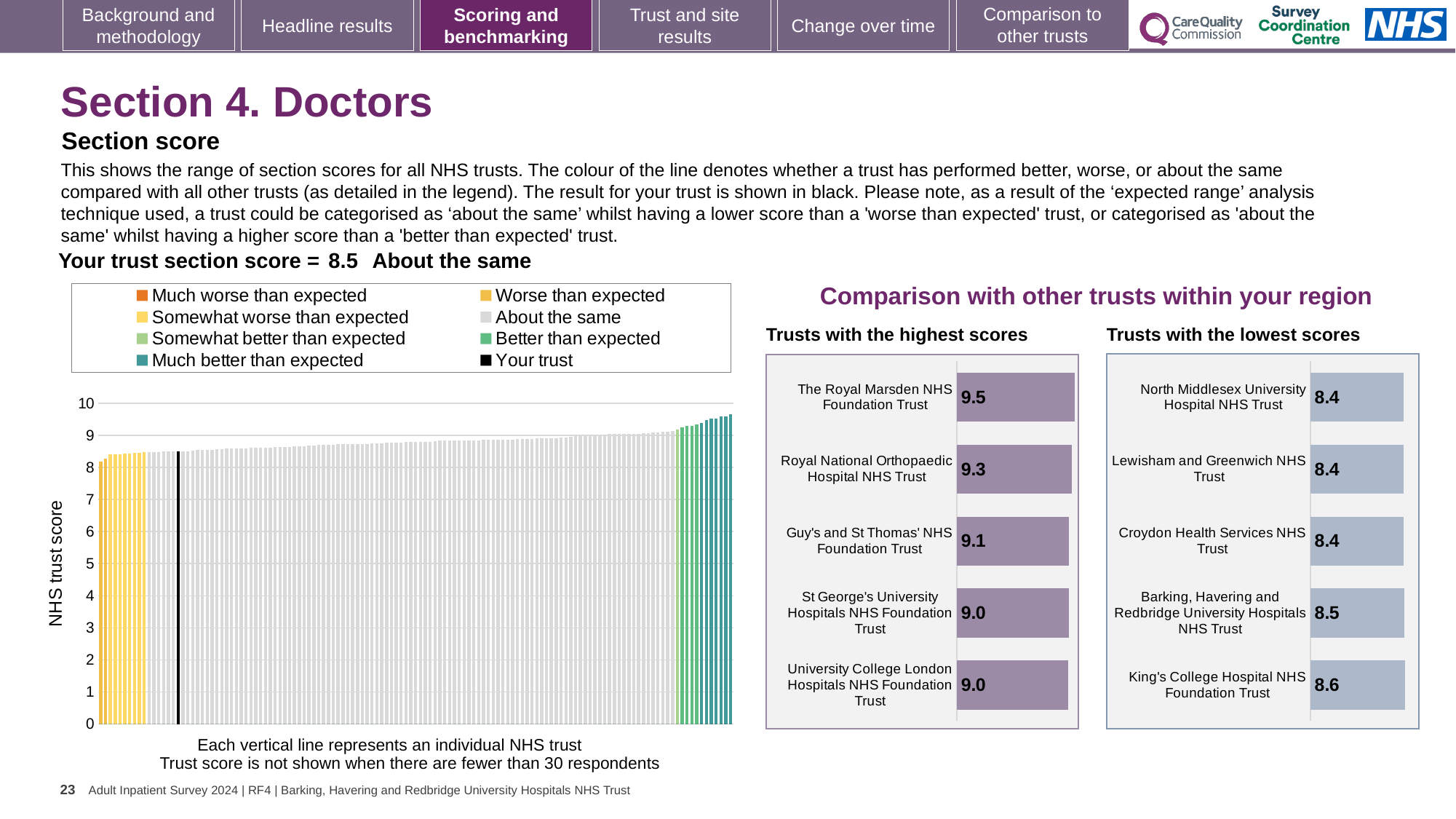
How many trusts are listed in the 'Trusts with the highest scores' chart? 5 In the 'Trusts with the highest scores' chart, which trust has the highest score? The Royal Marsden NHS Foundation Trust In the large chart on the left showing all NHS trusts, what is the section score for your trust (the black line)? 8.5 In the 'Trusts with the lowest scores' chart, which is larger: the score for King's College Hospital NHS Foundation Trust or the score for Croydon Health Services NHS Trust? King's College Hospital NHS Foundation Trust In the 'Trusts with the highest scores' chart, what is the difference between the scores of The Royal Marsden NHS Foundation Trust and Guy's and St Thomas' NHS Foundation Trust? 0.4 In the 'Trusts with the lowest scores' chart, what is the score for King's College Hospital NHS Foundation Trust? 8.6 In the large chart on the left showing all NHS trusts, do the trust scores rise or fall from left to right? rise In the 'Trusts with the highest scores' chart, what is the score for The Royal Marsden NHS Foundation Trust? 9.5 In the 'Trusts with the highest scores' chart, what is the score for Guy's and St Thomas' NHS Foundation Trust? 9.1 In the 'Trusts with the lowest scores' chart, what is the difference between the scores of King's College Hospital NHS Foundation Trust and Barking, Havering and Redbridge University Hospitals NHS Trust? 0.1 How many entries does the legend of the large chart on the left list? 8 In the 'Trusts with the lowest scores' chart, what is the score for Barking, Havering and Redbridge University Hospitals NHS Trust? 8.5